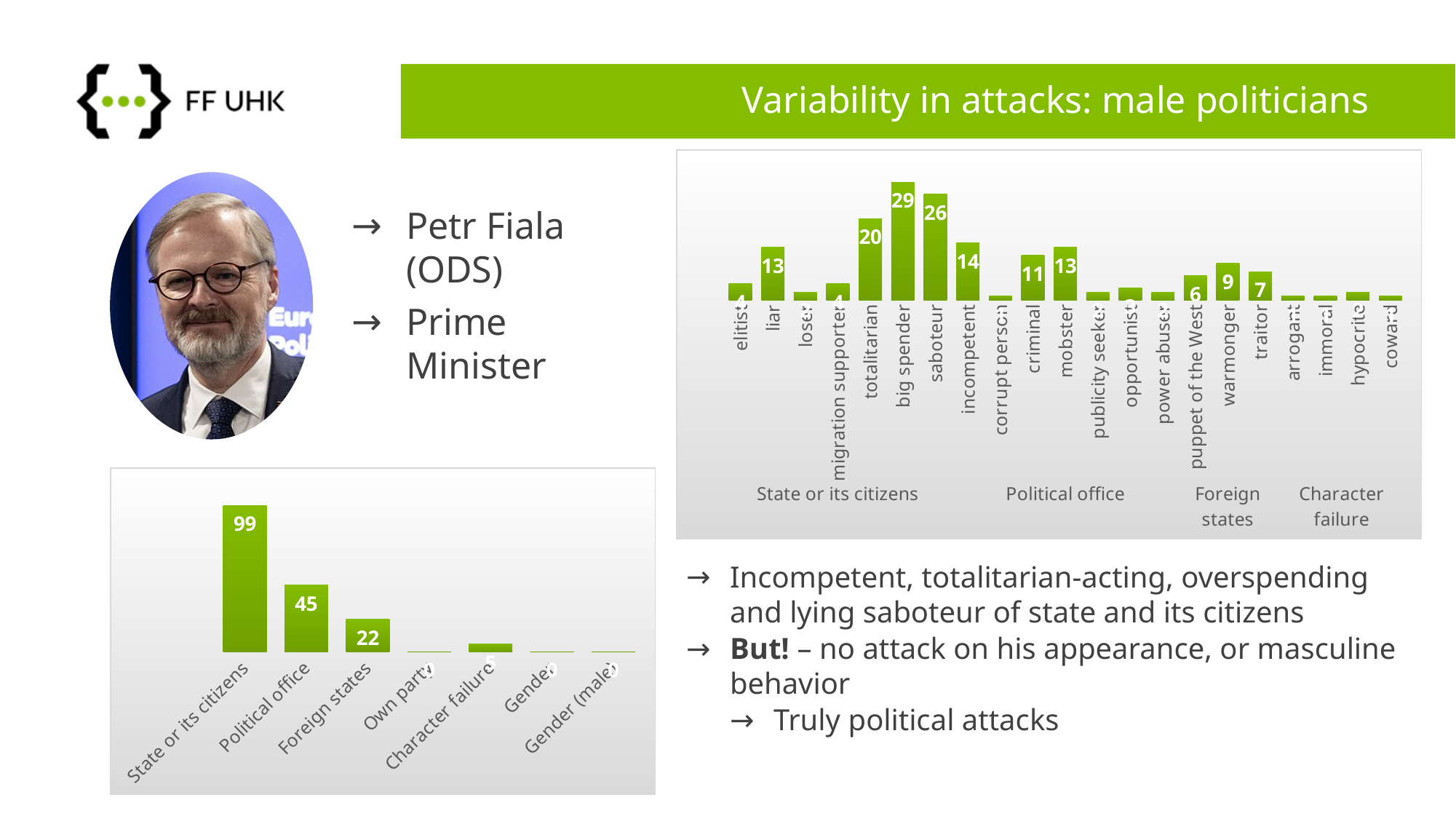
In the bottom-left chart, what is the value for Political office? 45 In the bottom-left chart, which category has the highest value? State or its citizens In the top-right chart, what is the difference between totalitarian and incompetent? 6 What type of chart is the top-right chart? Bar chart In the bottom-left chart, what is the value for State or its citizens? 99 In the top-right chart, which attack type has the highest value? big spender In the bottom-left chart, how many categories are shown on the x axis? 7 In the top-right chart, which is larger, warmonger or traitor? warmonger In the bottom-left chart, which is larger, Foreign states or Character failure? Foreign states In the top-right chart, what is the value for big spender? 29 In the bottom-left chart, what is the difference between State or its citizens and Political office? 54 In the top-right chart, what is the value for saboteur? 26